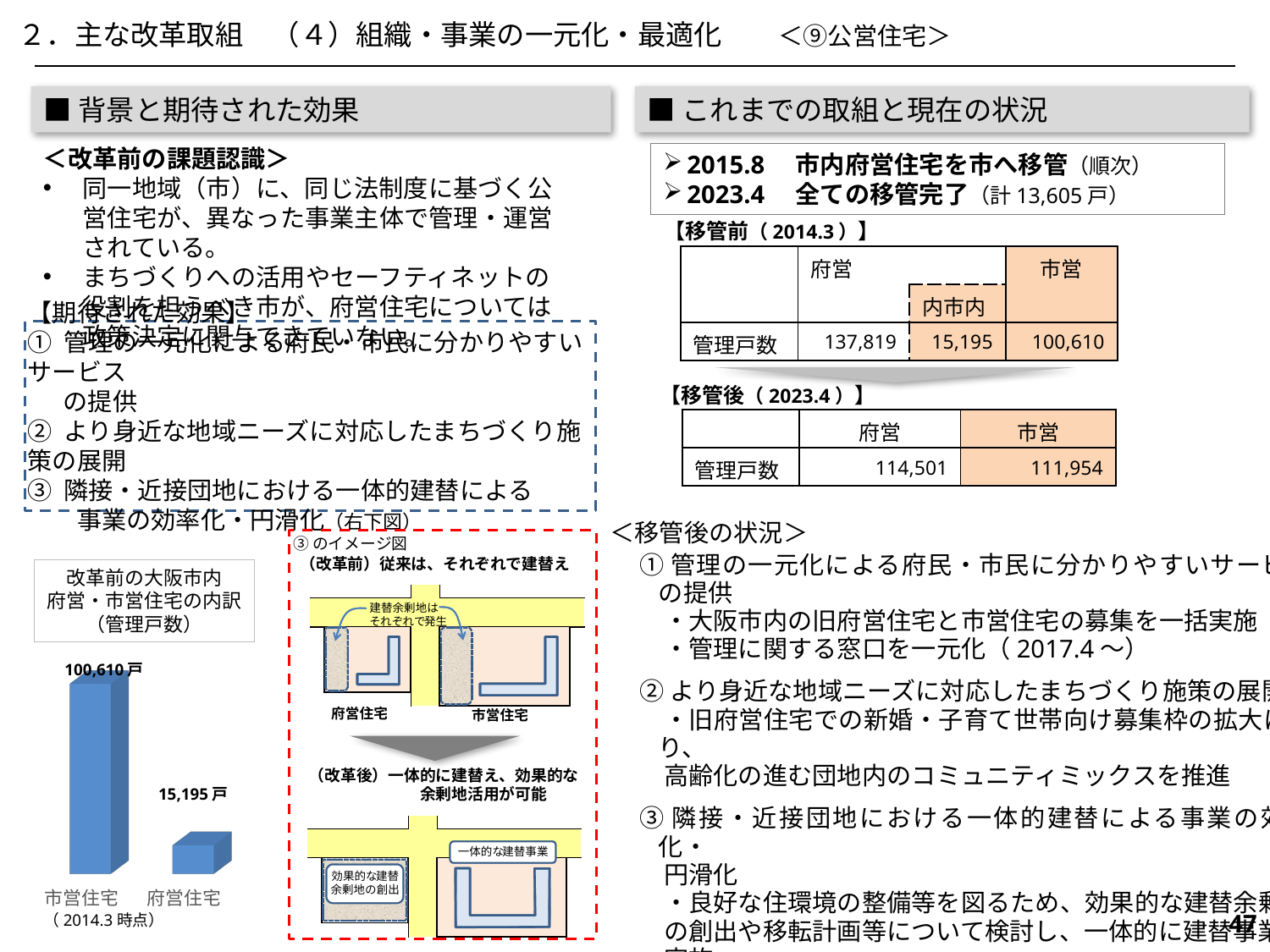
What is the value for 市営住宅 in the bar chart at the bottom left of the slide? 100,610 戸 What kind of chart is shown at the bottom left of the slide? Bar chart What is the title of the bar chart at the bottom left of the slide? 改革前の大阪市内 府営・市営住宅の内訳（管理戸数） In the bar chart at the bottom left, what is the difference between the values for 市営住宅 and 府営住宅? 85,415 戸 What is the total of the two values shown in the bar chart at the bottom left? 115,805 戸 In the bar chart at the bottom left, which category has the highest value? 市営住宅 In the bar chart at the bottom left, which category has the lowest value? 府営住宅 How many categories are shown in the bar chart at the bottom left of the slide? 2 What is the value for 府営住宅 in the bar chart at the bottom left of the slide? 15,195 戸 In the bar chart at the bottom left, which is larger: the value for 市営住宅 or the value for 府営住宅? 市営住宅 As of what point in time are the values in the bar chart at the bottom left given? 2014.3 時点